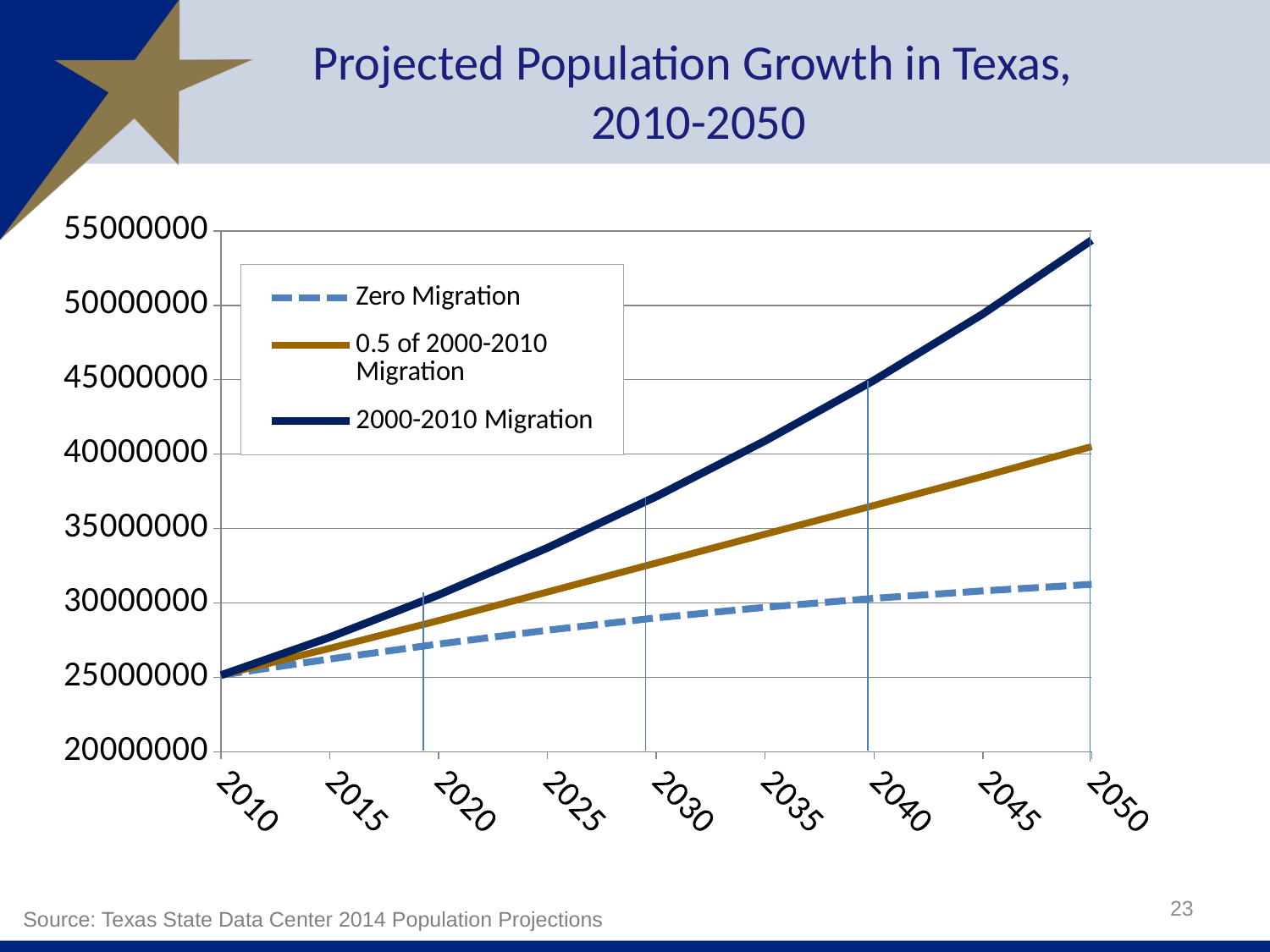
Which series has the lowest value in 2050? Zero Migration Which series has the highest value in 2050? 2000-2010 Migration Is the value for 2000-2010 Migration in 2050 greater or less than 50000000? greater In 2040, which is larger: the value for 2000-2010 Migration or the value for Zero Migration? 2000-2010 Migration Which series is drawn with a dashed line in the legend? Zero Migration Is the value for 2000-2010 Migration in 2030 greater or less than 35000000? greater Is the value for Zero Migration in 2030 greater or less than 30000000? less How many year labels are shown along the x axis? 9 What kind of chart is shown on the slide? line chart How many series does the legend list? 3 Do the values for the 2000-2010 Migration series rise or fall from 2010 to 2050? rise